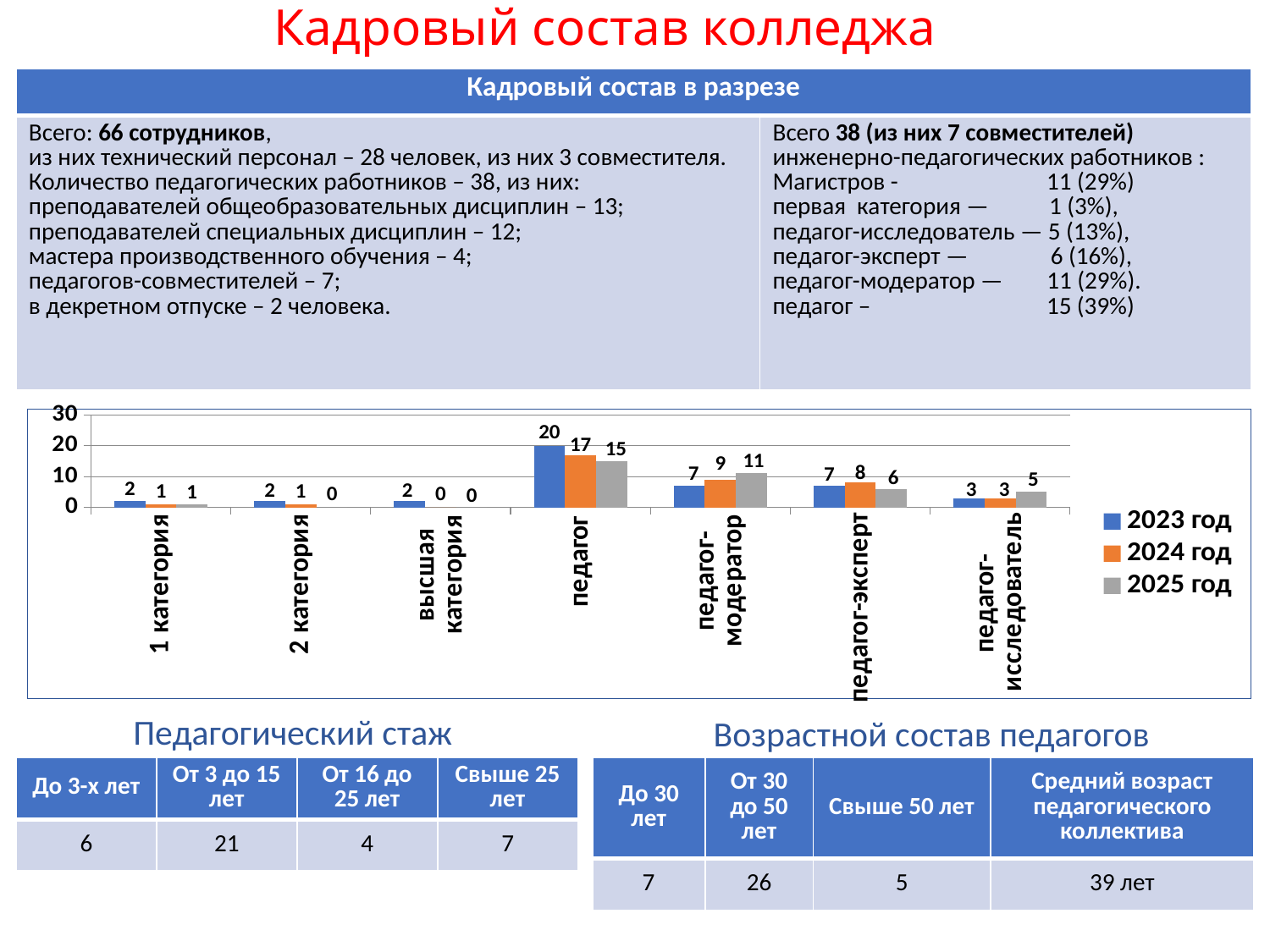
Which category has the highest value in the 2025 год series? педагог What is the difference between the 2023 год and 2025 год values for педагог? 5 How many categories are shown on the x axis of the chart? 7 What type of chart is shown on the slide? bar chart How many series does the chart legend list? 3 What is the value for высшая категория in 2024 год? 0 Which is larger for педагог-исследователь: the 2023 год value or the 2025 год value? 2025 год What is the value for педагог-эксперт in 2024 год? 8 What is the value for педагог in 2023 год? 20 What is the value for педагог-модератор in 2025 год? 11 Do the values for педагог-модератор rise or fall from 2023 год to 2025 год? rise Which series is shown in orange in the chart legend? 2024 год